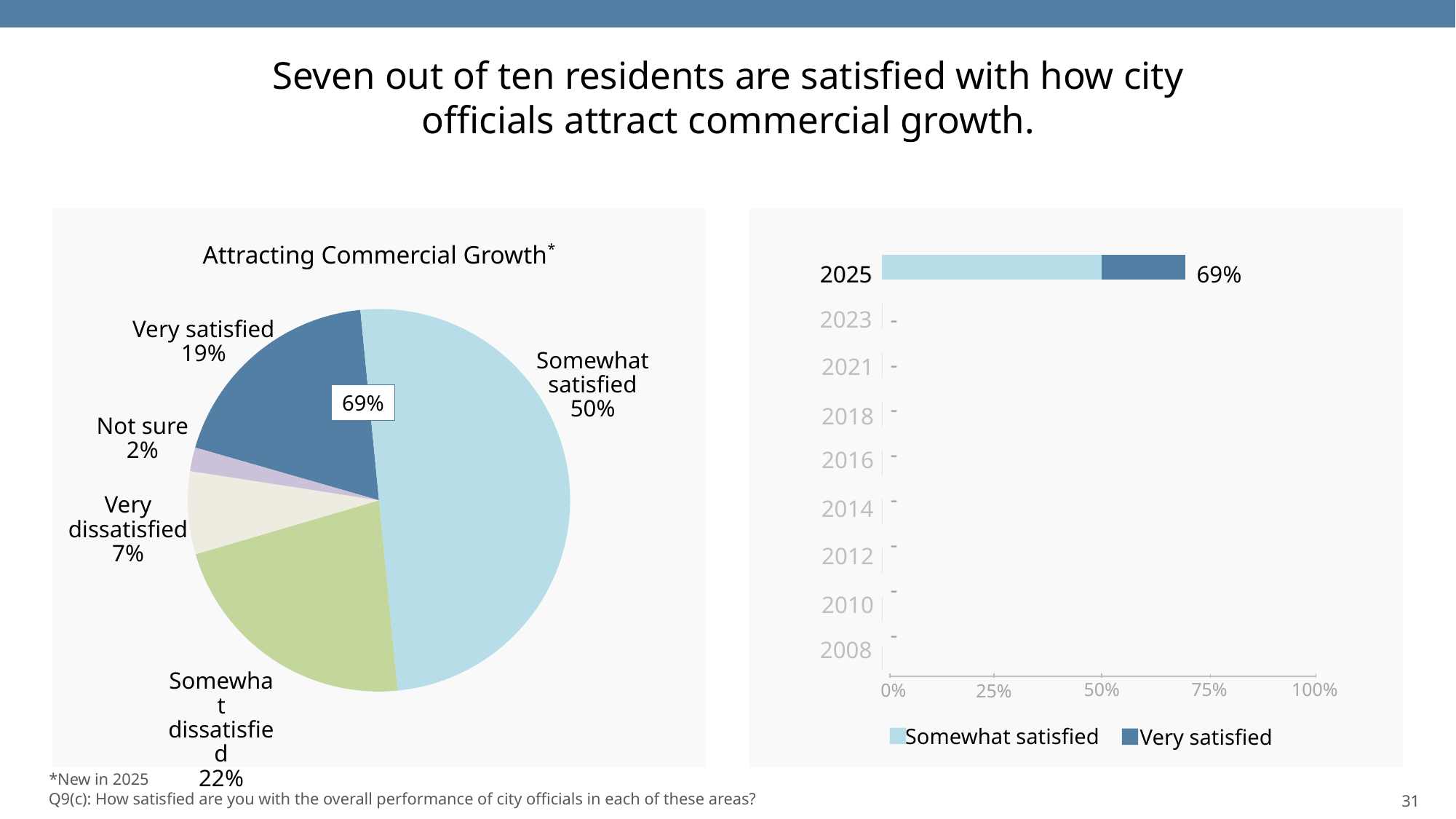
How many series does the legend of the bar chart on the right of the slide list? 2 In the pie chart titled Attracting Commercial Growth, what percentage of residents are somewhat satisfied? 50% In the pie chart titled Attracting Commercial Growth, which category has the largest slice? Somewhat satisfied In the pie chart titled Attracting Commercial Growth, what percentage of residents are very satisfied? 19% In the pie chart titled Attracting Commercial Growth, which category has the smallest slice? Not sure In the pie chart titled Attracting Commercial Growth, which is larger: Very satisfied or Very dissatisfied? Very satisfied What kind of chart is the chart on the left of the slide? Pie chart In the bar chart on the right of the slide, what is the total value shown for 2025? 69% How many slices does the pie chart titled Attracting Commercial Growth have? 5 How many year categories are listed on the vertical axis of the bar chart on the right of the slide? 9 What kind of chart is the chart on the right of the slide? Bar chart In the pie chart titled Attracting Commercial Growth, what is the difference in percentage points between Somewhat satisfied and Somewhat dissatisfied? 28 percentage points